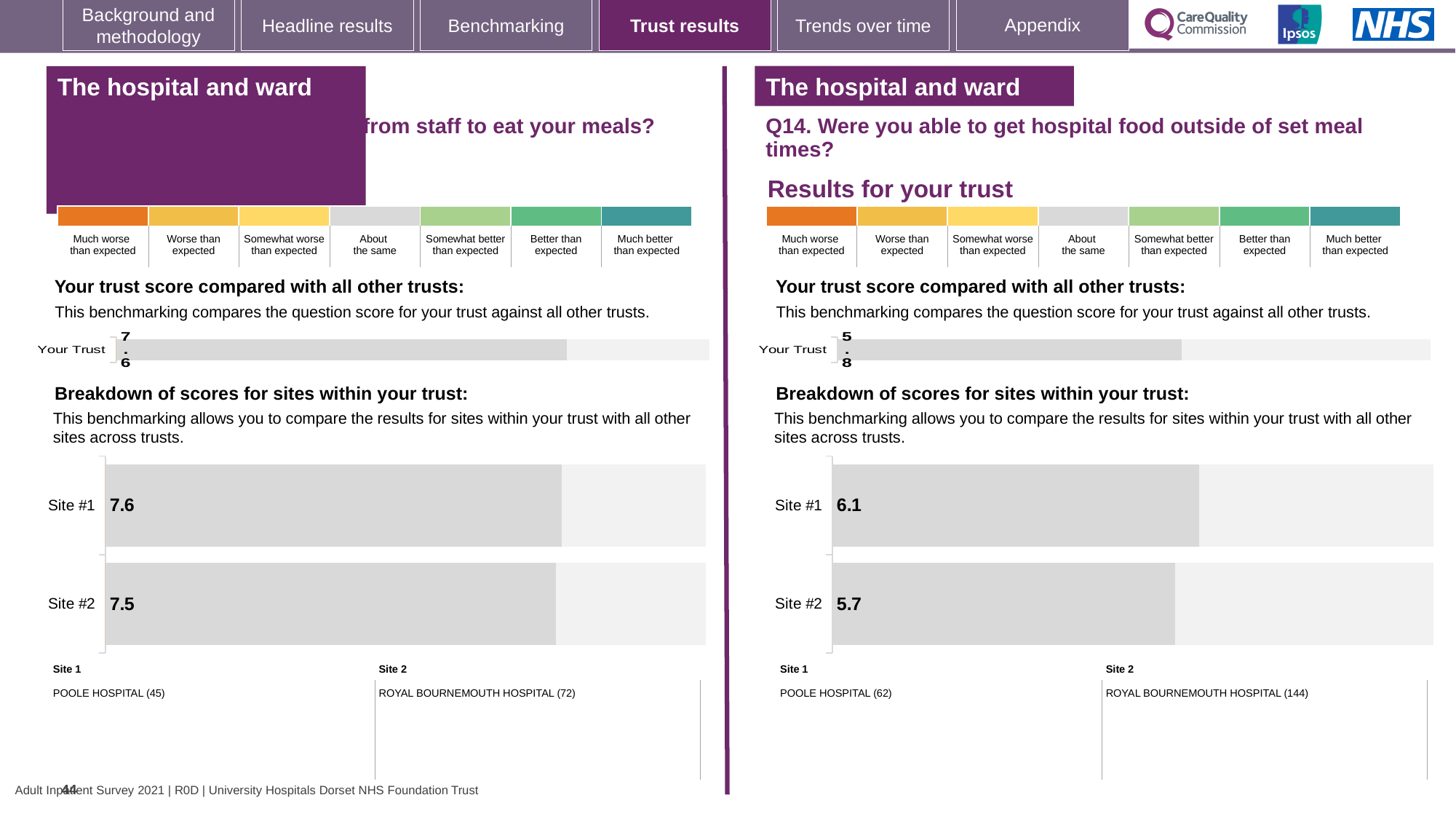
On the right-hand side of the slide (Q14), what is the 'Your Trust' score compared with all other trusts? 5.8 On the right-hand side of the slide, which hospital is listed as Site 2? ROYAL BOURNEMOUTH HOSPITAL (144) On the left-hand side of the slide, what is the 'Your Trust' score compared with all other trusts? 7.6 On the right-hand chart for Q14, which site has the higher score? Site #1 On the left-hand site breakdown chart, what is the score for Site #1? 7.6 What type of chart is used for the breakdown of scores for sites within the trust on the right-hand side? Bar chart On the right-hand chart for Q14, what is the difference between the Site #1 and Site #2 scores? 0.4 On the left-hand site breakdown chart, what is the score for Site #2? 7.5 On the right-hand chart for Q14 (hospital food outside of set meal times), what is the score for Site #1? 6.1 On the left-hand site breakdown chart, what is the difference between the Site #1 and Site #2 scores? 0.1 How many sites are shown in the site breakdown chart on the right-hand side (Q14)? 2 On the right-hand chart for Q14 (hospital food outside of set meal times), what is the score for Site #2? 5.7